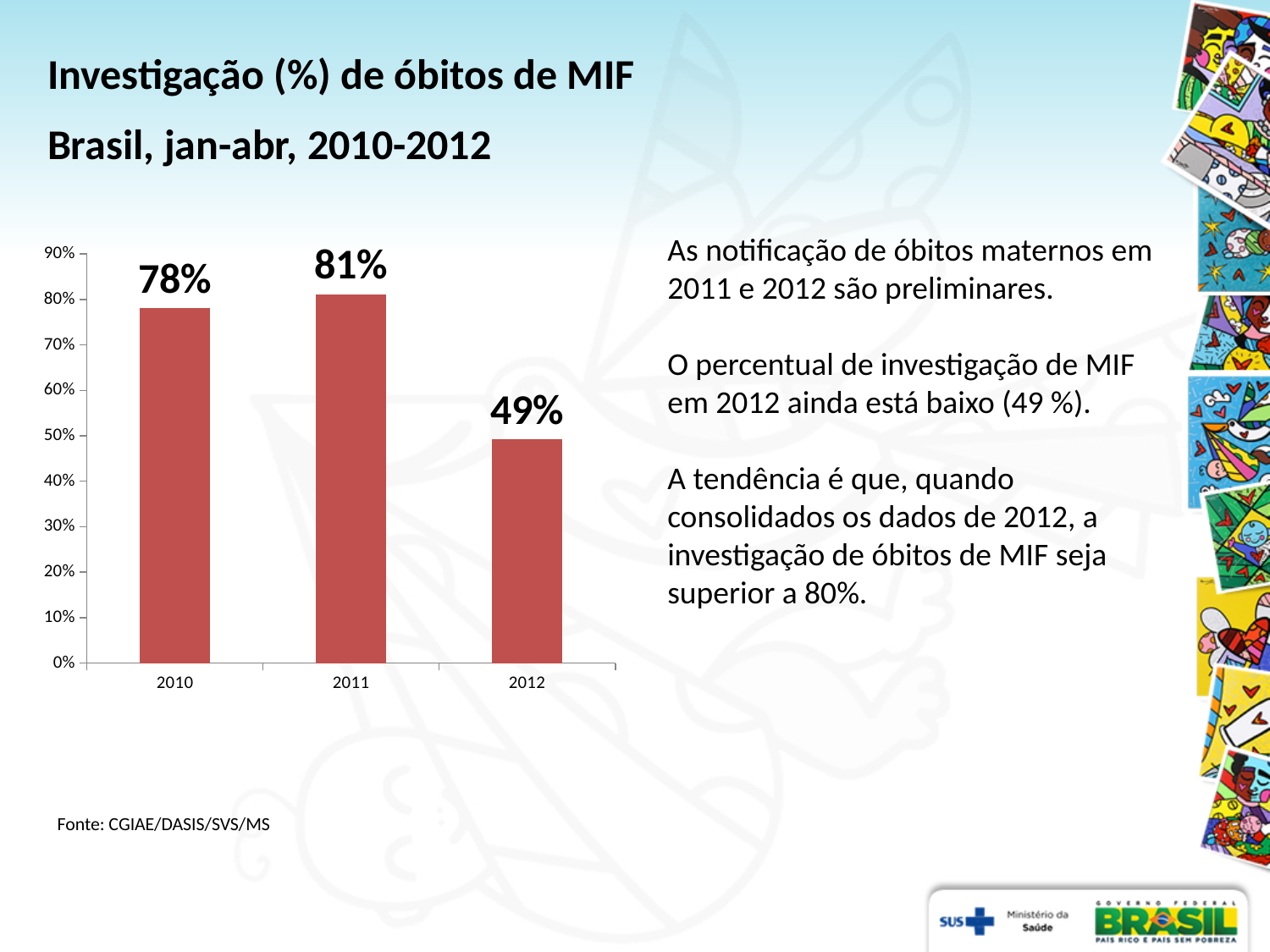
What is the investigation percentage for 2011? 81% What is the difference between the 2011 and 2010 values? 3% What is the maximum value shown on the chart's y axis? 90% What kind of chart is shown on the slide? bar chart Is the value for 2012 greater or less than 50%? less Which year has the highest investigation percentage? 2011 Which is larger, the value for 2010 or the value for 2012? 2010 Which year has the lowest investigation percentage? 2012 What is the investigation percentage for 2012? 49% What is the investigation percentage for 2010? 78% How many years are shown on the x axis of the chart? 3 What is the difference between the 2011 and 2012 values? 32%